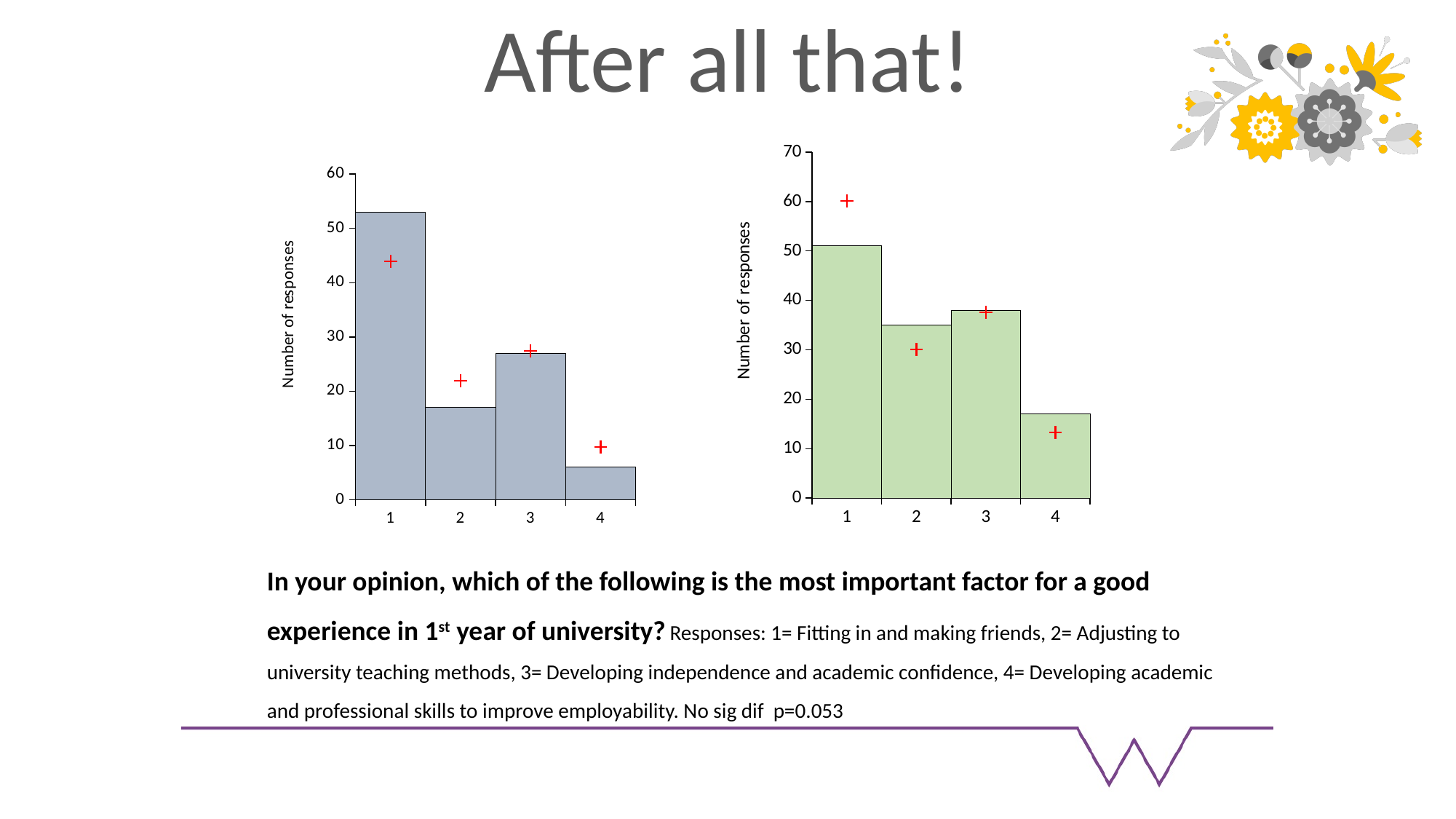
In the right chart, is the value for category 4 greater or less than 20? less In the left chart, which category has the lowest number of responses? 4 In the right chart, which category has the lowest number of responses? 4 How many categories are shown on the x axis of the right chart? 4 In the left chart, is the value for category 1 greater or less than 50? greater In the right chart, which category has the highest number of responses? 1 In the left chart, which category has the highest number of responses? 1 What is the y-axis label of the right chart? Number of responses In the left chart, is the value for category 4 greater or less than 10? less In the left chart, which is larger, the value for category 2 or category 3? category 3 What kind of chart is the left chart on the slide? bar chart